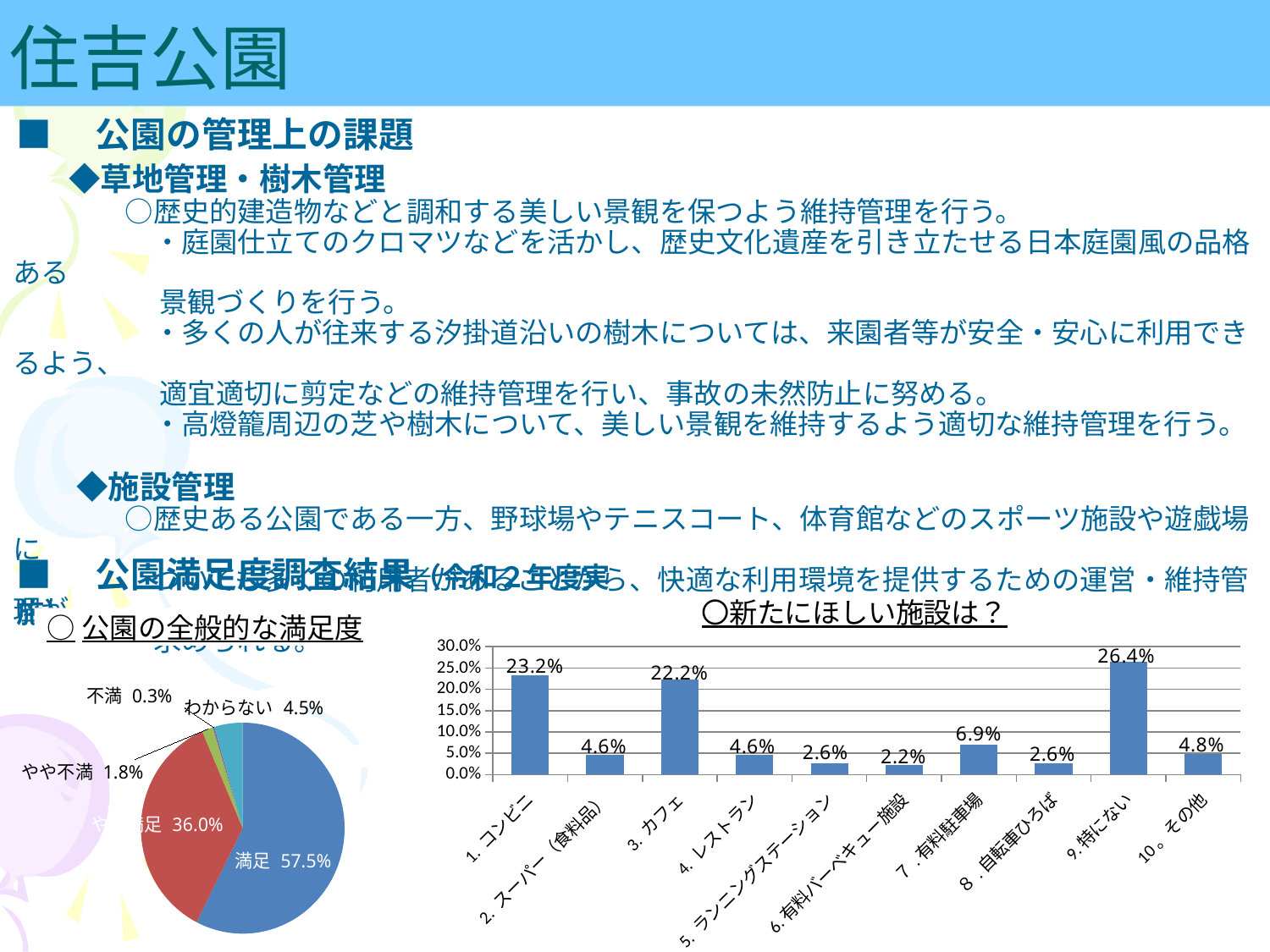
In the bar chart titled 新たにほしい施設は？, what is the value for 1.コンビニ? 23.2% In the bar chart titled 新たにほしい施設は？, what is the value for 7.有料駐車場? 6.9% In the bar chart titled 新たにほしい施設は？, which is larger, the value for 1.コンビニ or the value for 3.カフェ? 1.コンビニ In the pie chart titled 公園の全般的な満足度, what is the difference between the shares for 満足 and やや満足? 21.5% In the bar chart titled 新たにほしい施設は？, what is the difference between the values for 9.特にない and 3.カフェ? 4.2% In the pie chart titled 公園の全般的な満足度, which slice is the smallest? 不満 In the bar chart titled 新たにほしい施設は？, which category has the lowest value? 6.有料バーベキュー施設 What kind of chart is the chart titled 新たにほしい施設は？? bar chart In the pie chart titled 公園の全般的な満足度, what is the share for 満足? 57.5% In the pie chart titled 公園の全般的な満足度, what is the value for わからない? 4.5% In the bar chart titled 新たにほしい施設は？, which category has the highest value? 9.特にない In the bar chart titled 新たにほしい施設は？, how many categories are shown? 10